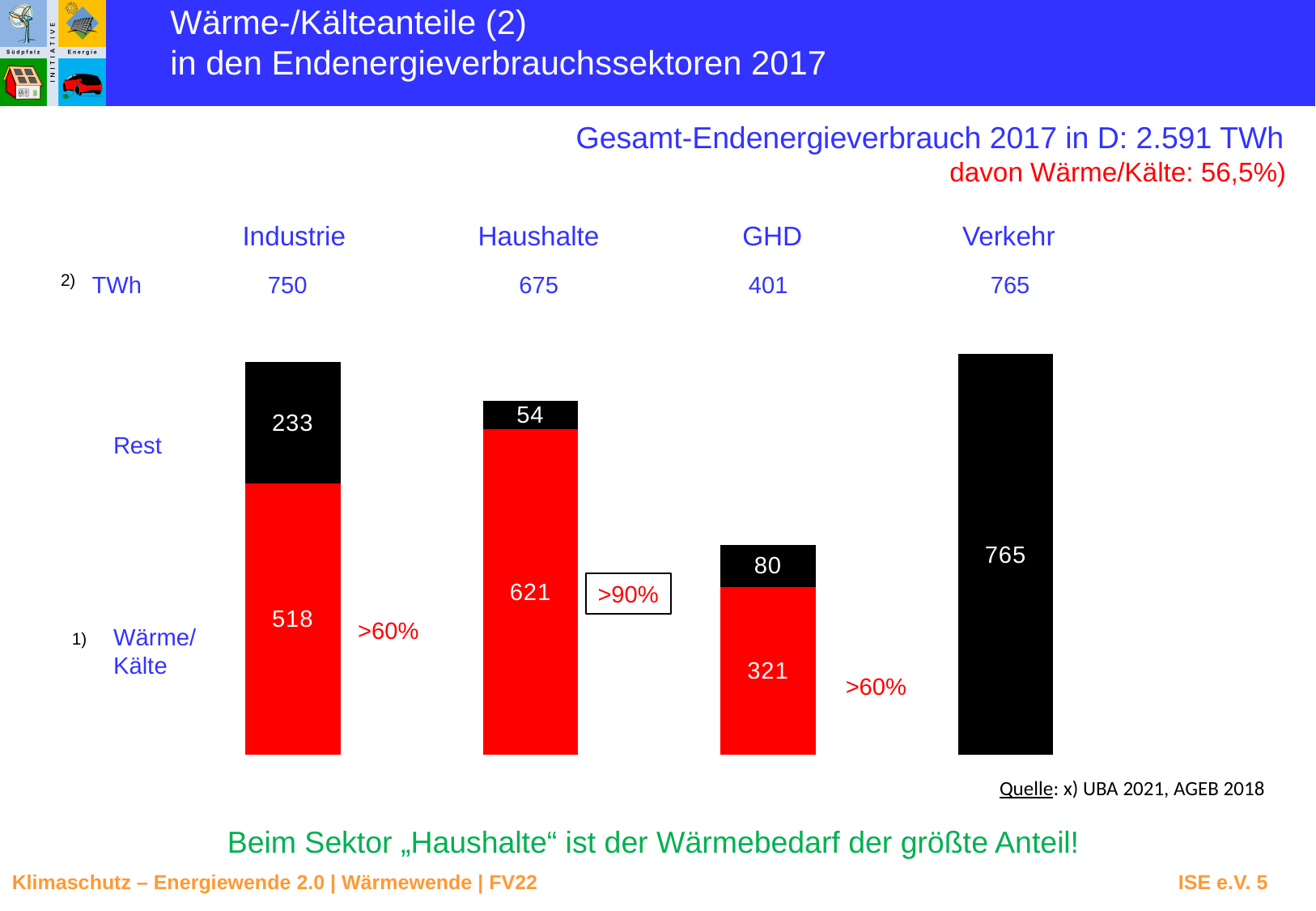
What is the Wärme/Kälte value for Industrie? 518 What kind of chart is shown on the slide? Stacked bar chart How many sectors are shown in the chart? 4 What is the Rest value for Haushalte? 54 Which sector has the lowest Rest value? Haushalte What is the Rest value for Verkehr? 765 What is the Wärme/Kälte value for GHD? 321 What is the total of the stacked bar for Industrie (Rest plus Wärme/Kälte)? 751 Which is larger, the Rest value for Industrie or the Rest value for GHD? Industrie Which sector has the highest Wärme/Kälte value? Haushalte What colour represents the Wärme/Kälte segments in the chart? Red What is the difference between the Wärme/Kälte values for Industrie and GHD? 197